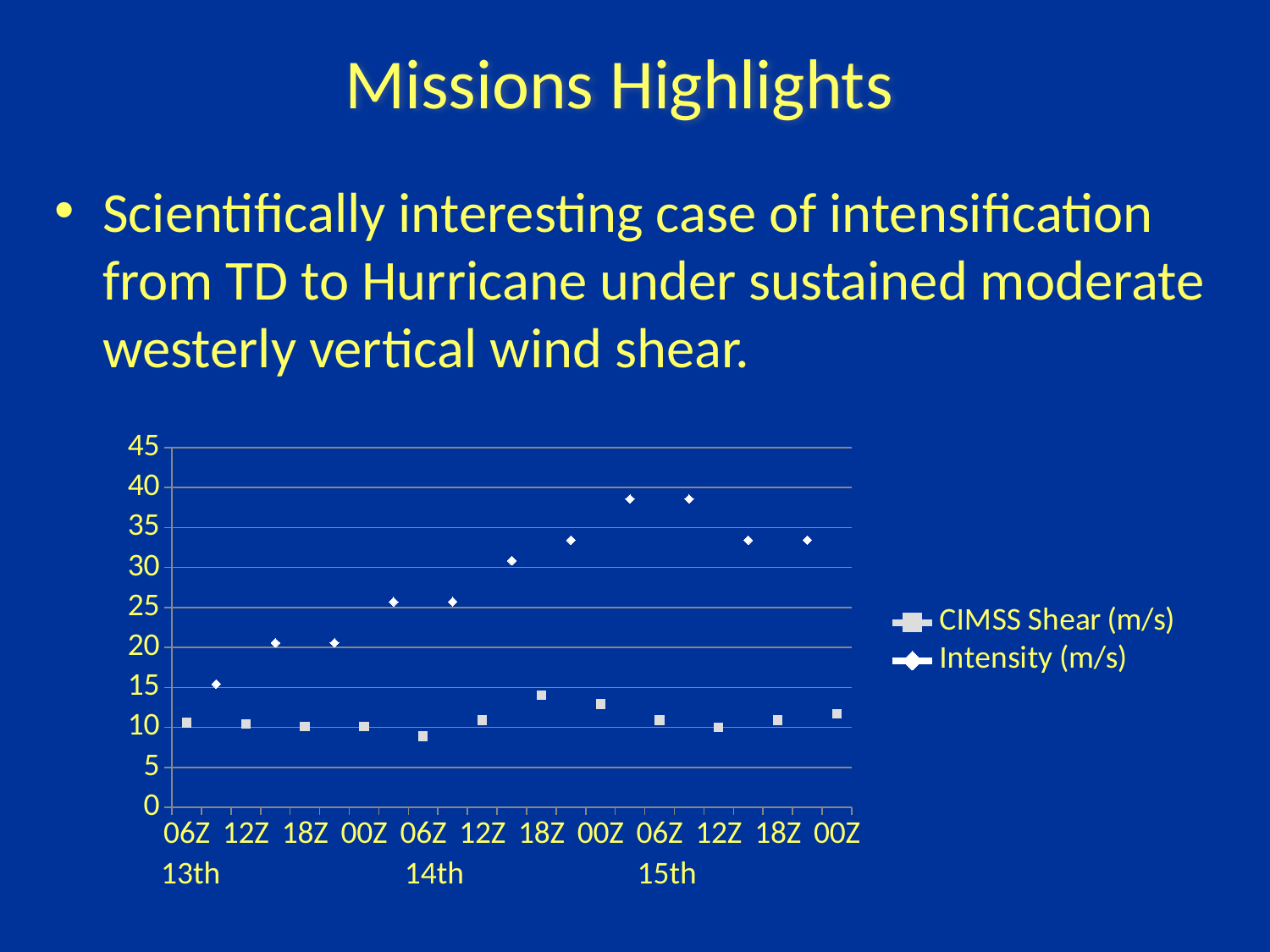
How many time points (x-axis categories) are shown on the chart? 12 Is the CIMSS Shear (m/s) value at 06Z on the 14th greater or less than 10? less How many series does the chart legend list? 2 Which days are labelled along the x axis of the chart? 13th, 14th, 15th Which series reaches the highest value on the chart, CIMSS Shear (m/s) or Intensity (m/s)? Intensity (m/s) What are the two series named in the chart legend? CIMSS Shear (m/s) and Intensity (m/s) At 00Z on the 15th, which is larger: the Intensity (m/s) value or the CIMSS Shear (m/s) value? Intensity (m/s) Is the highest CIMSS Shear (m/s) value greater or less than 15? less Is the highest Intensity (m/s) value greater or less than 35? greater What kind of chart is shown on the slide? Line chart Does the Intensity (m/s) series generally rise or fall from the 13th to the 15th? rise